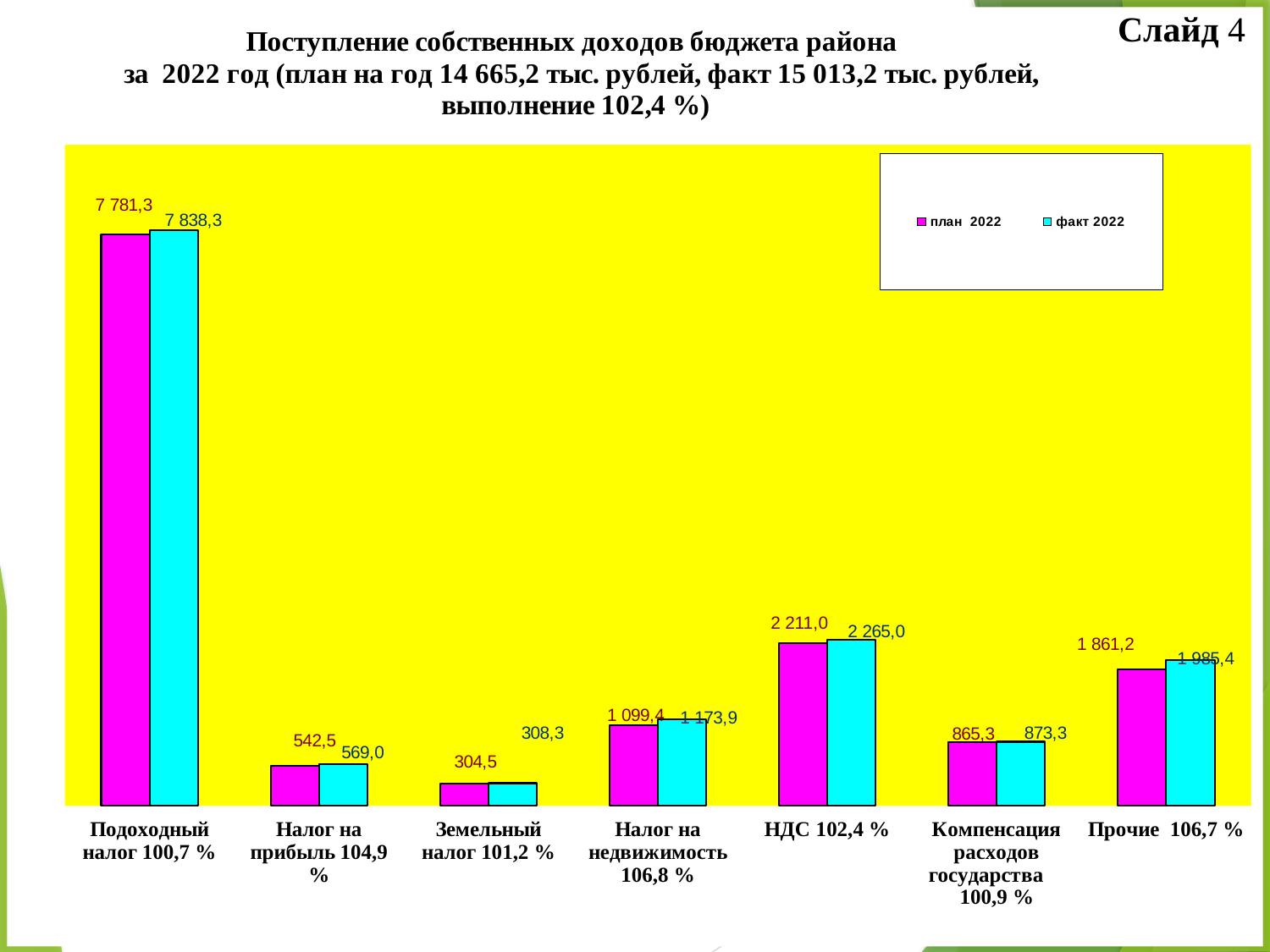
What is the факт 2022 value for Налог на прибыль? 569,0 How many categories are shown on the x axis? 7 What type of chart is shown on the slide? bar chart What is the факт 2022 value for Подоходный налог? 7 838,3 What is the план 2022 value for Подоходный налог? 7 781,3 Which category has the highest факт 2022 value? Подоходный налог What is the difference between the факт 2022 and план 2022 values for НДС? 54,0 What is the план 2022 value for НДС? 2 211,0 Which is larger for Земельный налог: the план 2022 value or the факт 2022 value? факт 2022 How many series does the legend list? 2 What is the факт 2022 value for Компенсация расходов государства? 873,3 Which category has the lowest план 2022 value? Земельный налог